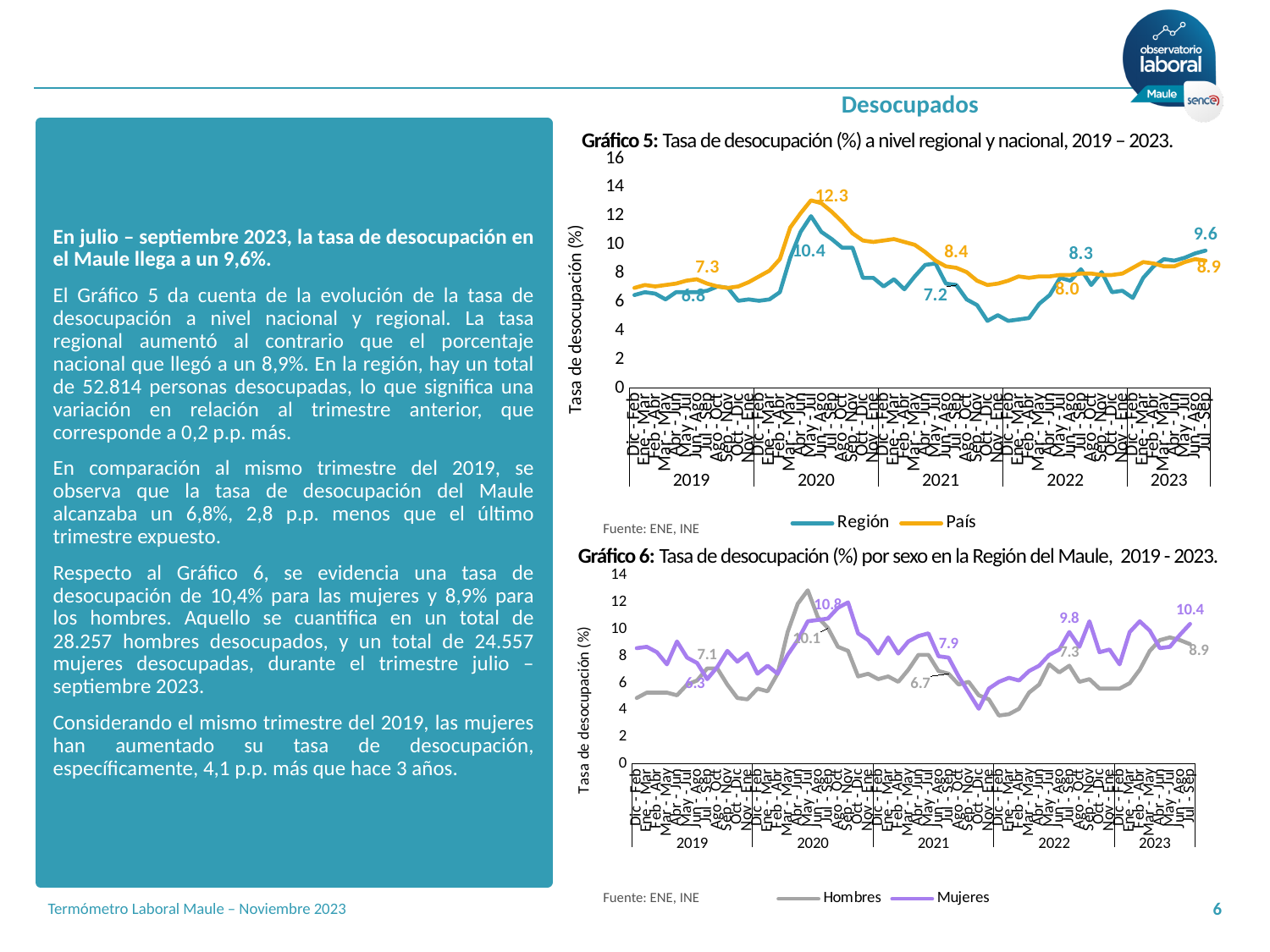
What kind of chart is Gráfico 5? Line chart In Gráfico 5, at the 2020 peak, which series is higher: Región or País? País In Gráfico 5, what is the labelled peak value of the País series in 2020? 12.3 In Gráfico 5, what is the difference between the last labelled Región value (9.6) and the last labelled País value (8.9)? 0.7 In Gráfico 6, what is the last labelled value of the Mujeres series in 2023? 10.4 In Gráfico 5, what is the last labelled value of the Región series in 2023? 9.6 In Gráfico 6, what is the last labelled value of the Hombres series in 2023? 8.9 In Gráfico 5, is the lowest point of the Región series in late 2021 greater or less than 6? less In Gráfico 6, what is the highest labelled value of the Mujeres series? 10.8 How many series does the legend of Gráfico 5 list? 2 In Gráfico 6, what is the difference between the last labelled Mujeres value (10.4) and the last labelled Hombres value (8.9)? 1.5 Which two series are listed in the legend of Gráfico 6? Hombres and Mujeres